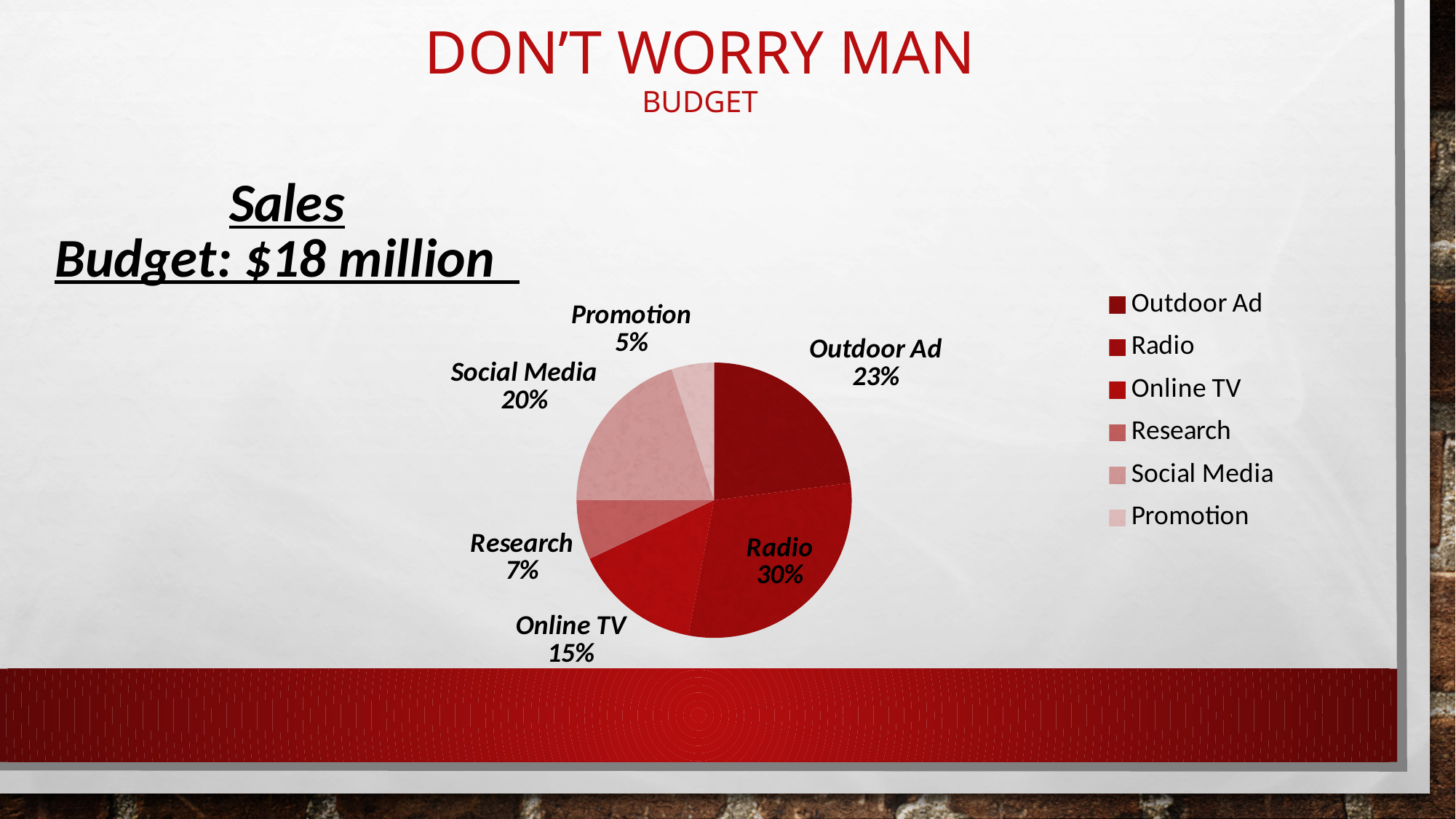
What percentage of the budget is allocated to Social Media? 20% How many categories are shown in the pie chart? 6 What type of chart is shown on the slide? Pie chart How many entries does the legend list? 6 Which category has the largest share of the budget? Radio What is the difference in percentage points between Radio and Outdoor Ad? 7 What percentage of the budget is allocated to Radio? 30% What percentage of the budget is allocated to Research? 7% Which has a larger share, Online TV or Social Media? Social Media What is the total sales budget stated on the slide? $18 million What is the combined share of Outdoor Ad and Online TV? 38% Which category has the smallest share of the budget? Promotion